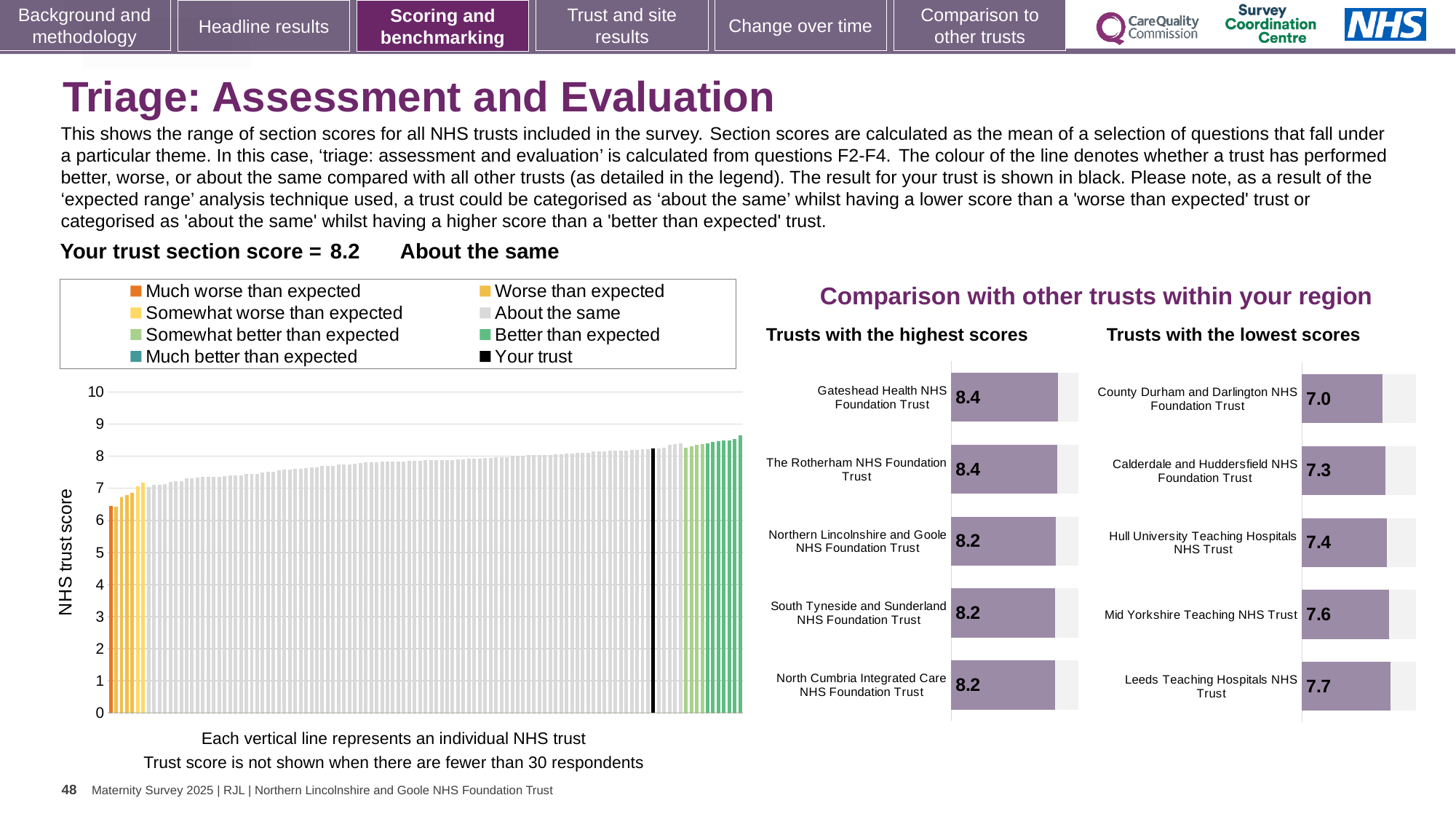
What kind of chart is the 'Trusts with the lowest scores' chart? bar chart In the 'Trusts with the lowest scores' chart, which trust has the lowest score? County Durham and Darlington NHS Foundation Trust In the main NHS trust score chart on the left, what is the section score for your trust (shown in black)? 8.2 Is the score for Mid Yorkshire Teaching NHS Trust in the 'Trusts with the lowest scores' chart larger or smaller than the score for Calderdale and Huddersfield NHS Foundation Trust? larger How many trusts are shown in the 'Trusts with the highest scores' chart? 5 In the 'Trusts with the highest scores' chart, what is the difference between the score for The Rotherham NHS Foundation Trust and the score for North Cumbria Integrated Care NHS Foundation Trust? 0.2 How many entries does the legend of the main NHS trust score chart list? 8 In the 'Trusts with the highest scores' chart, what is the score for Gateshead Health NHS Foundation Trust? 8.4 In the 'Trusts with the lowest scores' chart, which trust has the highest score? Leeds Teaching Hospitals NHS Trust In the main NHS trust score chart on the left, do the values rise or fall from left to right along the x axis? rise In the 'Trusts with the lowest scores' chart, what is the difference between the score for Leeds Teaching Hospitals NHS Trust and the score for County Durham and Darlington NHS Foundation Trust? 0.7 In the 'Trusts with the lowest scores' chart, what is the score for Hull University Teaching Hospitals NHS Trust? 7.4